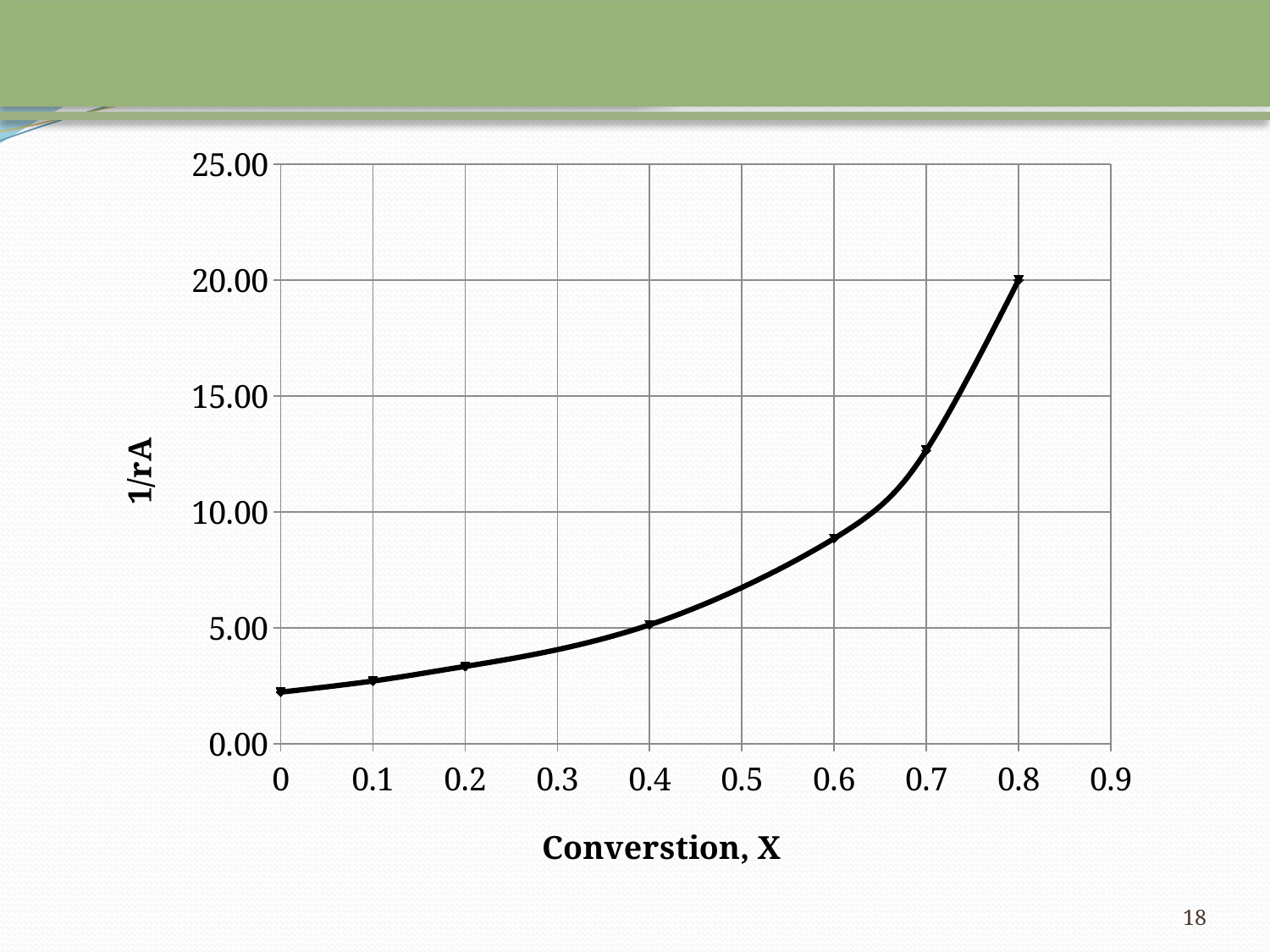
Is the value of 1/rA at Conversion X = 0.6 greater or less than 10.00? less Which has the larger value of 1/rA: Conversion X = 0.6 or Conversion X = 0.7? 0.7 Is the value of 1/rA at Conversion X = 0.7 greater or less than 10.00? greater What is the title of the x axis? Converstion, X What is the title of the y axis? 1/rA Do the values of 1/rA rise or fall as Conversion X increases? rise What kind of chart is shown on the slide? line chart At which value of Conversion X is 1/rA highest? 0.8 How many data points are plotted on the line? 7 Is the value of 1/rA at Conversion X = 0.2 greater or less than 5.00? less What is the value of 1/rA at Conversion X = 0.8? 20.00 At which value of Conversion X is 1/rA lowest? 0